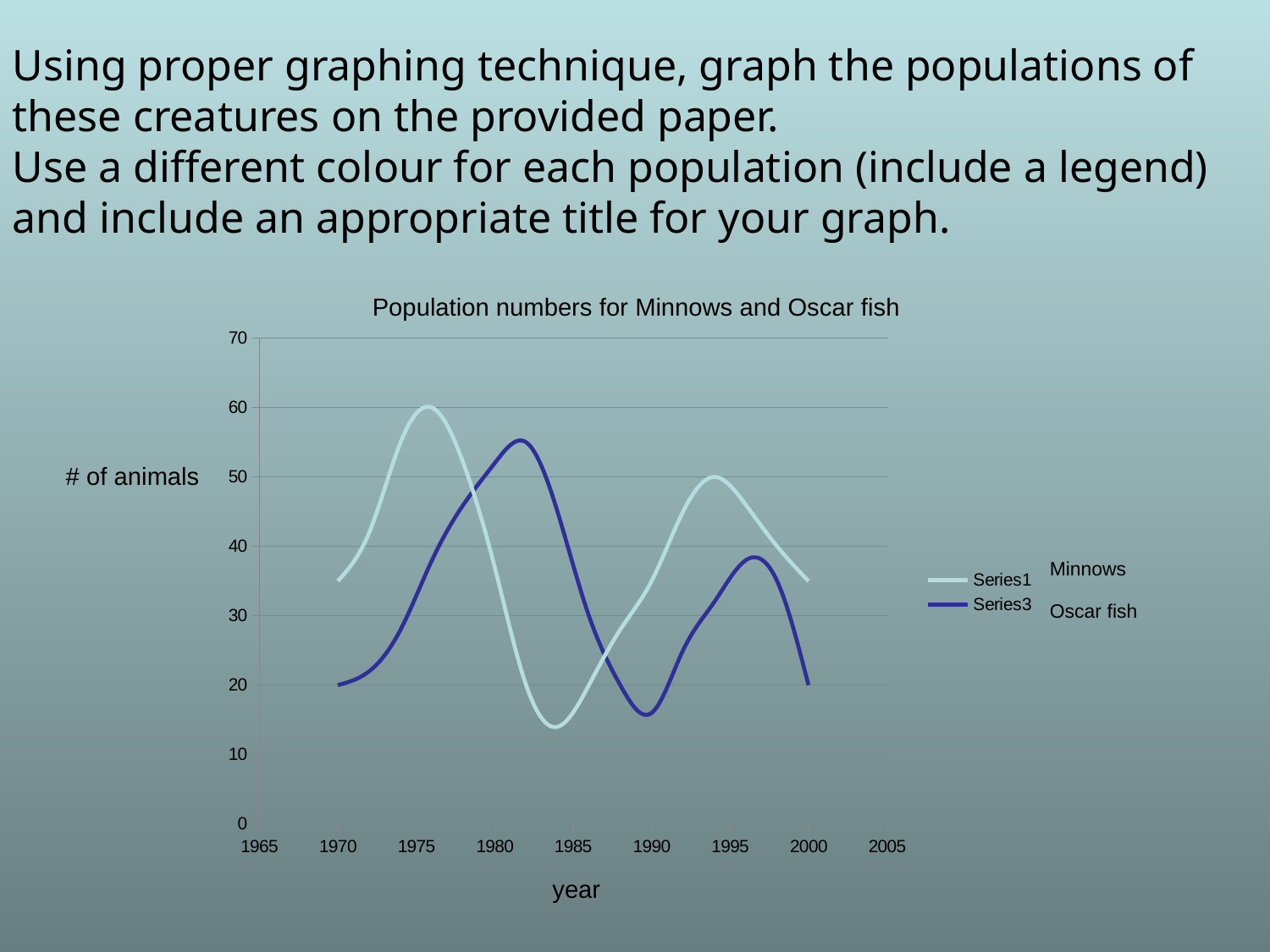
What type of chart is shown on the slide? line chart What is the title of the chart? Population numbers for Minnows and Oscar fish How many series does the legend list? 2 Is the Oscar fish value in 1990 greater or less than 30? less Is the Oscar fish value in 1995 greater or less than 30? greater In 1975, which population is larger, Minnows or Oscar fish? Minnows Which population is plotted with the dark blue line? Oscar fish Does the Oscar fish population rise or fall between 1995 and 2000? fall Is the Minnows value in 1975 greater or less than 50? greater What is the Oscar fish population in 2000? 20 What is the Oscar fish population in 1970? 20